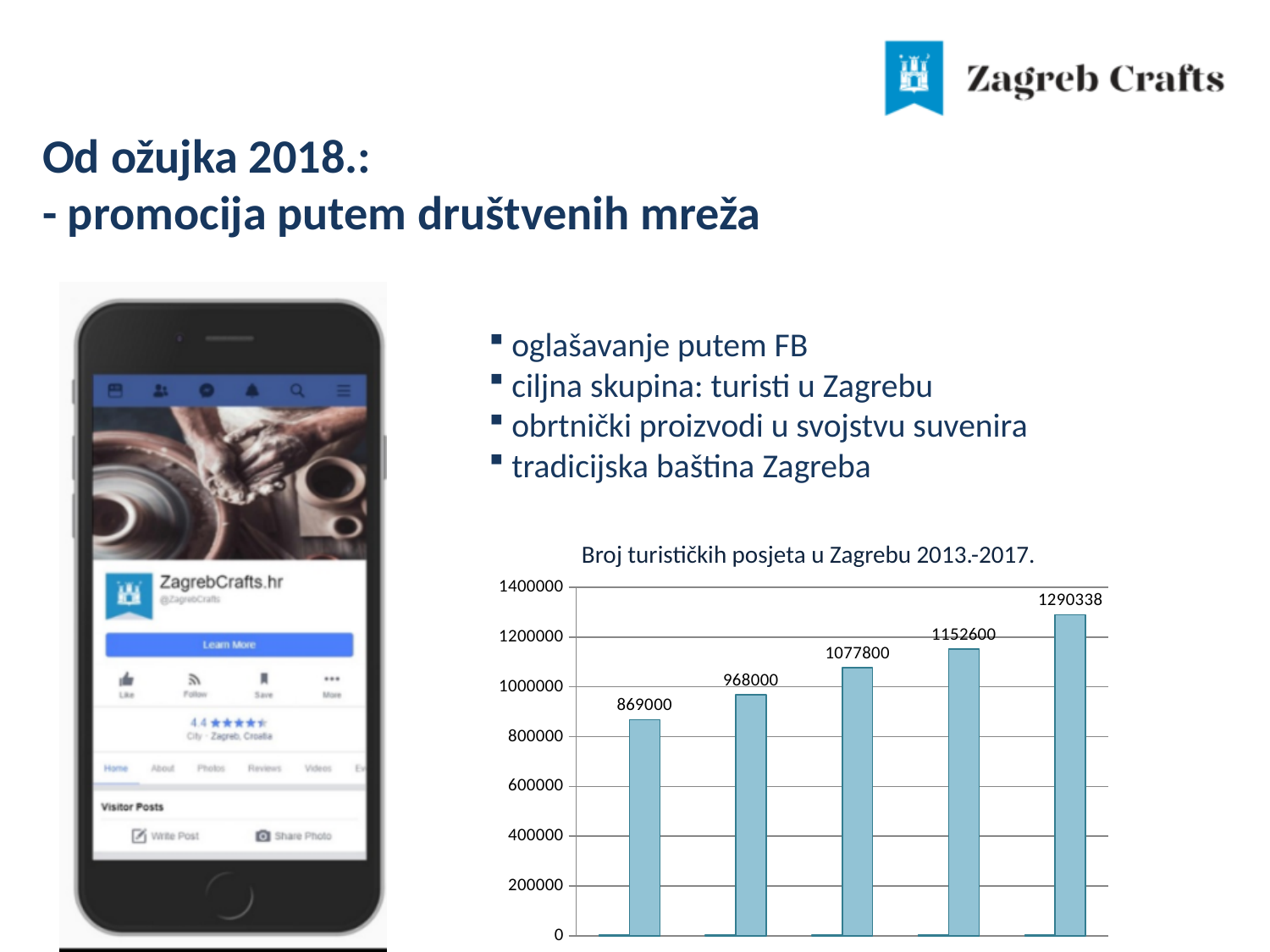
What is the highest value shown in the chart? 1290338 What type of chart is shown on the slide? bar chart What is the value of the third bar in the chart? 1077800 What is the difference between the last bar and the first bar in the chart? 421338 What is the difference between the second bar and the first bar in the chart? 99000 Do the values rise or fall from left to right across the chart? rise What is the title of the chart on the slide? Broj turističkih posjeta u Zagrebu 2013.-2017. What is the value of the last (rightmost) bar in the chart? 1290338 What is the value of the first (leftmost) bar in the chart? 869000 How many bars are plotted in the chart? 5 What is the lowest value shown in the chart? 869000 Which is larger, the fourth bar or the second bar? the fourth bar